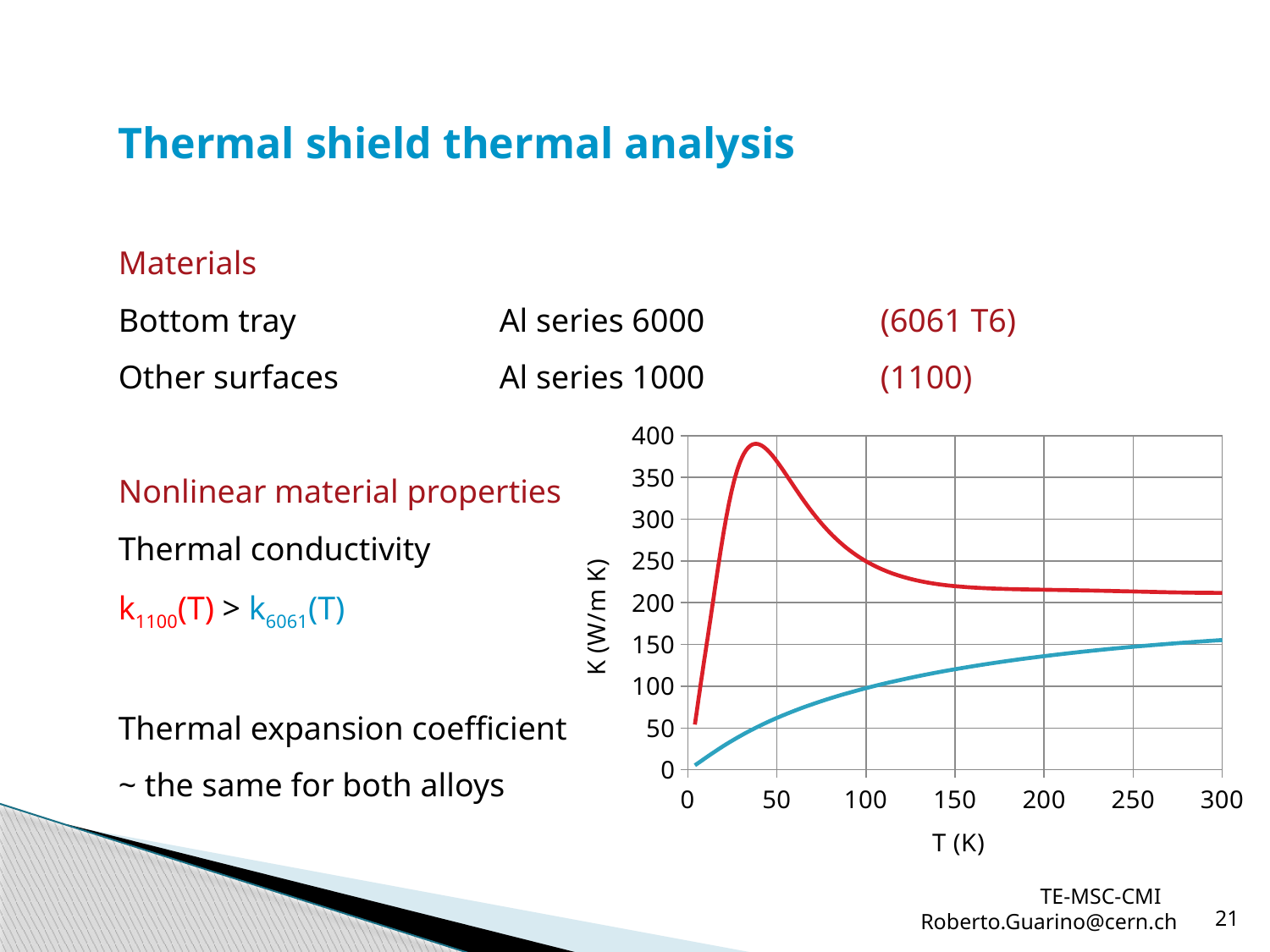
Is the value of the blue line at T = 300 K greater or less than 200? less Which line reaches the highest value on the chart, the red line or the blue line? red line Is the peak value of the red line greater or less than 350? greater What kind of chart is shown on the slide? line chart Is the value of the blue line at T = 50 K greater or less than 100? less Which line has the higher value at T = 100 K, the red line or the blue line? red line Does the red line rise or fall as T increases from 100 K to 300 K? falls What is the label of the y axis of the chart? K (W/m K) What is the label of the x axis of the chart? T (K) Does the blue line rise or fall as T increases from 0 to 300 K? rises How many lines are plotted on the chart? 2